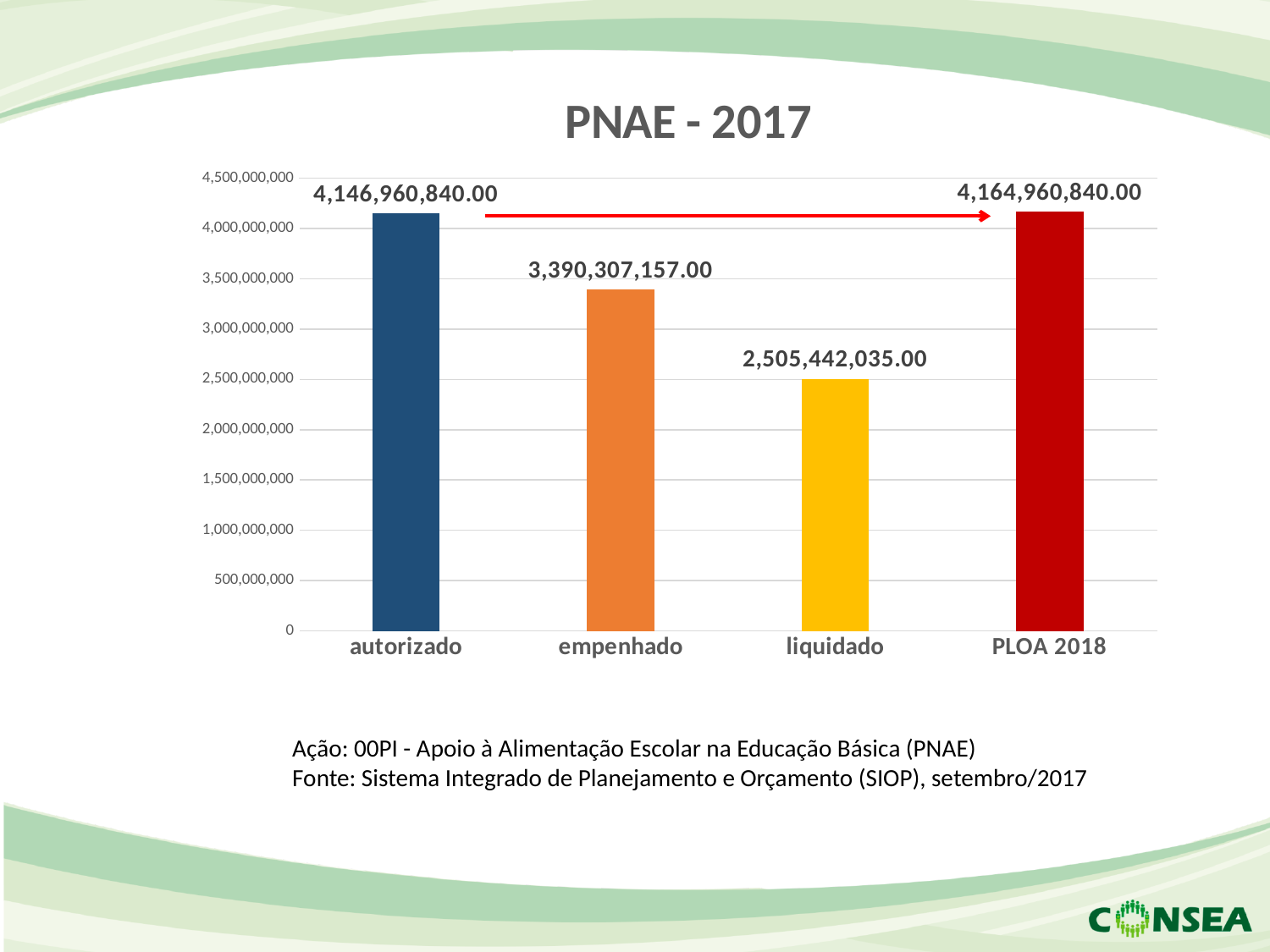
What is the value for autorizado? 4,146,960,840.00 How many categories are shown on the x axis? 4 Which category has the lowest value? liquidado What kind of chart is shown on the slide? bar chart What is the value for empenhado? 3,390,307,157.00 What is the difference between the values for autorizado and empenhado? 756,653,683.00 What is the value for PLOA 2018? 4,164,960,840.00 What is the value for liquidado? 2,505,442,035.00 Which category has the highest value? PLOA 2018 What is the difference between the values for PLOA 2018 and autorizado? 18,000,000.00 Which is larger, the value for empenhado or the value for liquidado? empenhado Is the value for empenhado greater or less than 3,000,000,000? greater